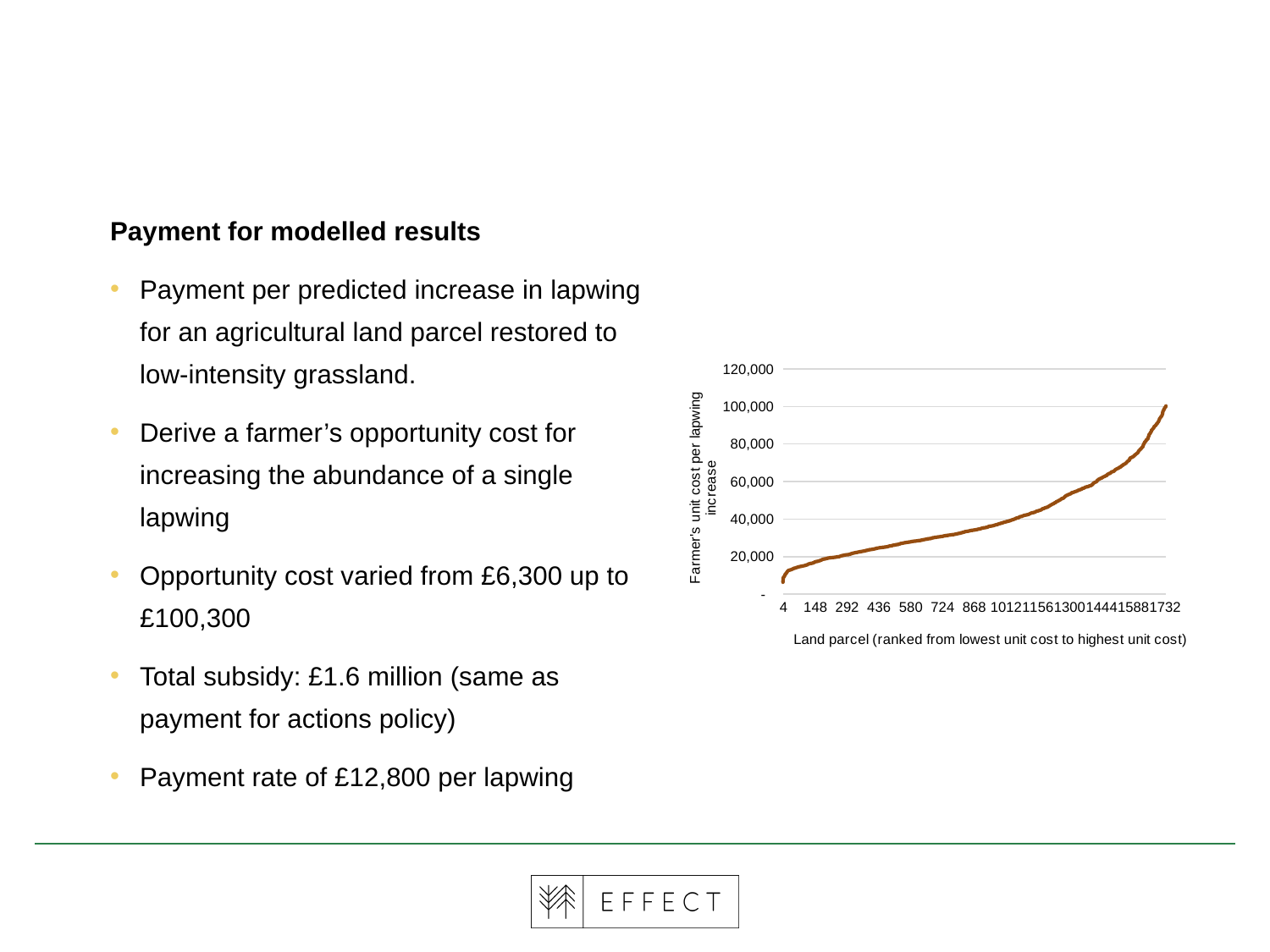
Is the farmer's unit cost per lapwing increase for land parcel 868 greater or less than 40,000? less Do the values on the chart rise or fall as you move from left to right along the x axis? rise Which land parcel on the x axis has the lowest farmer's unit cost per lapwing increase? 4 Is the farmer's unit cost per lapwing increase for land parcel 868 greater or less than 20,000? greater What is the label of the y axis on the chart? Farmer's unit cost per lapwing increase Is the farmer's unit cost per lapwing increase for land parcel 1732 greater or less than 80,000? greater What is the label of the x axis on the chart? Land parcel (ranked from lowest unit cost to highest unit cost) What kind of chart is shown on the slide? line chart Which has the larger farmer's unit cost per lapwing increase, land parcel 148 or land parcel 1444? 1444 Which land parcel on the x axis has the highest farmer's unit cost per lapwing increase? 1732